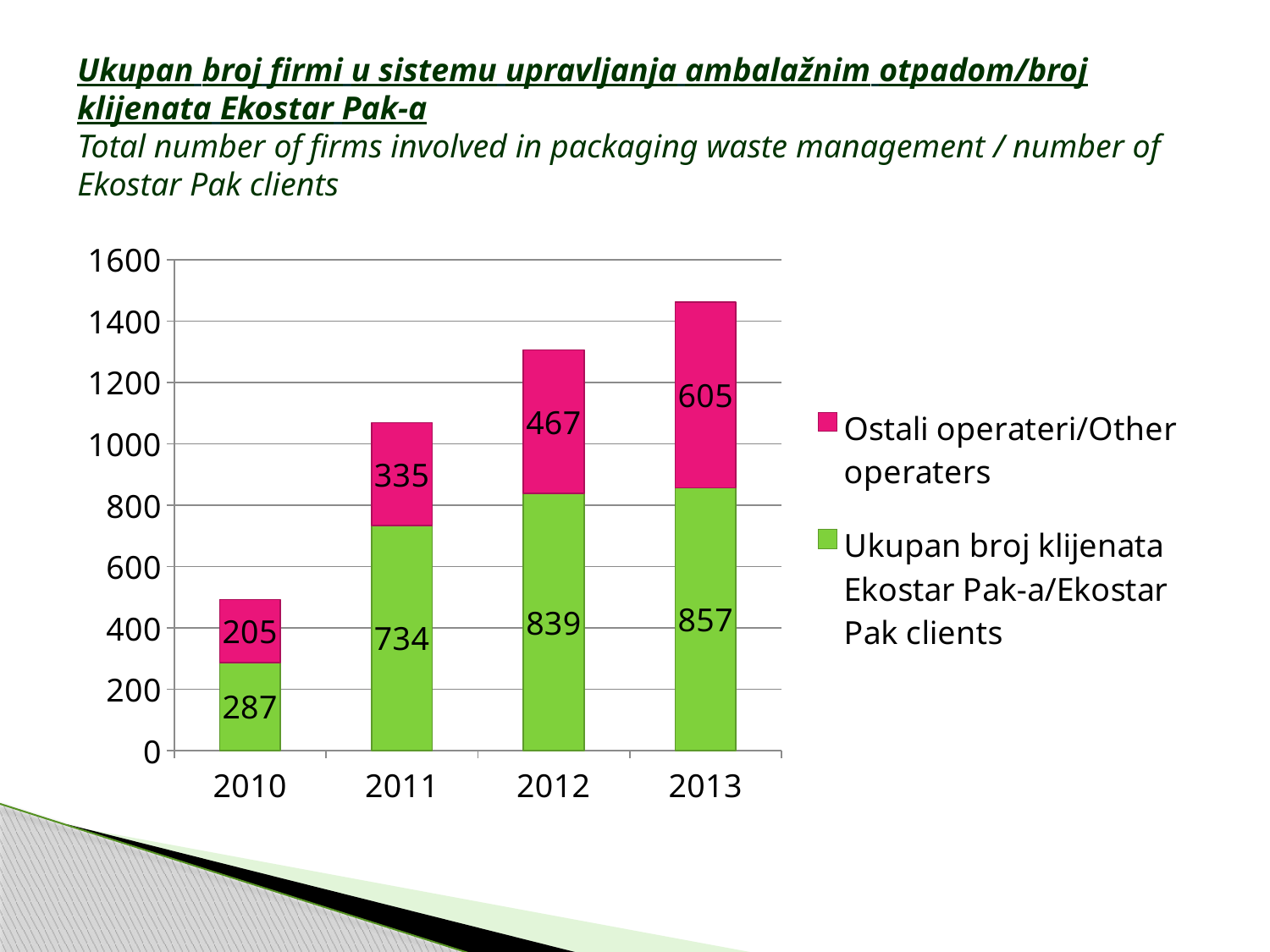
How many years are shown on the x axis? 4 Which year has the highest number of Ekostar Pak clients? 2013 What kind of chart is shown on the slide? Stacked bar chart What is the difference between the Ekostar Pak clients values for 2011 and 2010? 447 How many series does the legend list? 2 Which is larger in 2013: Ekostar Pak clients or Other operaters? Ekostar Pak clients What is the number of Ekostar Pak clients in 2012? 839 What is the value for Other operaters in 2011? 335 What is the total of the stacked bar for 2010? 492 Which year has the lowest value for Other operaters? 2010 Do the Other operaters values rise or fall from 2010 to 2013? Rise What is the total of the stacked bar for 2013? 1462